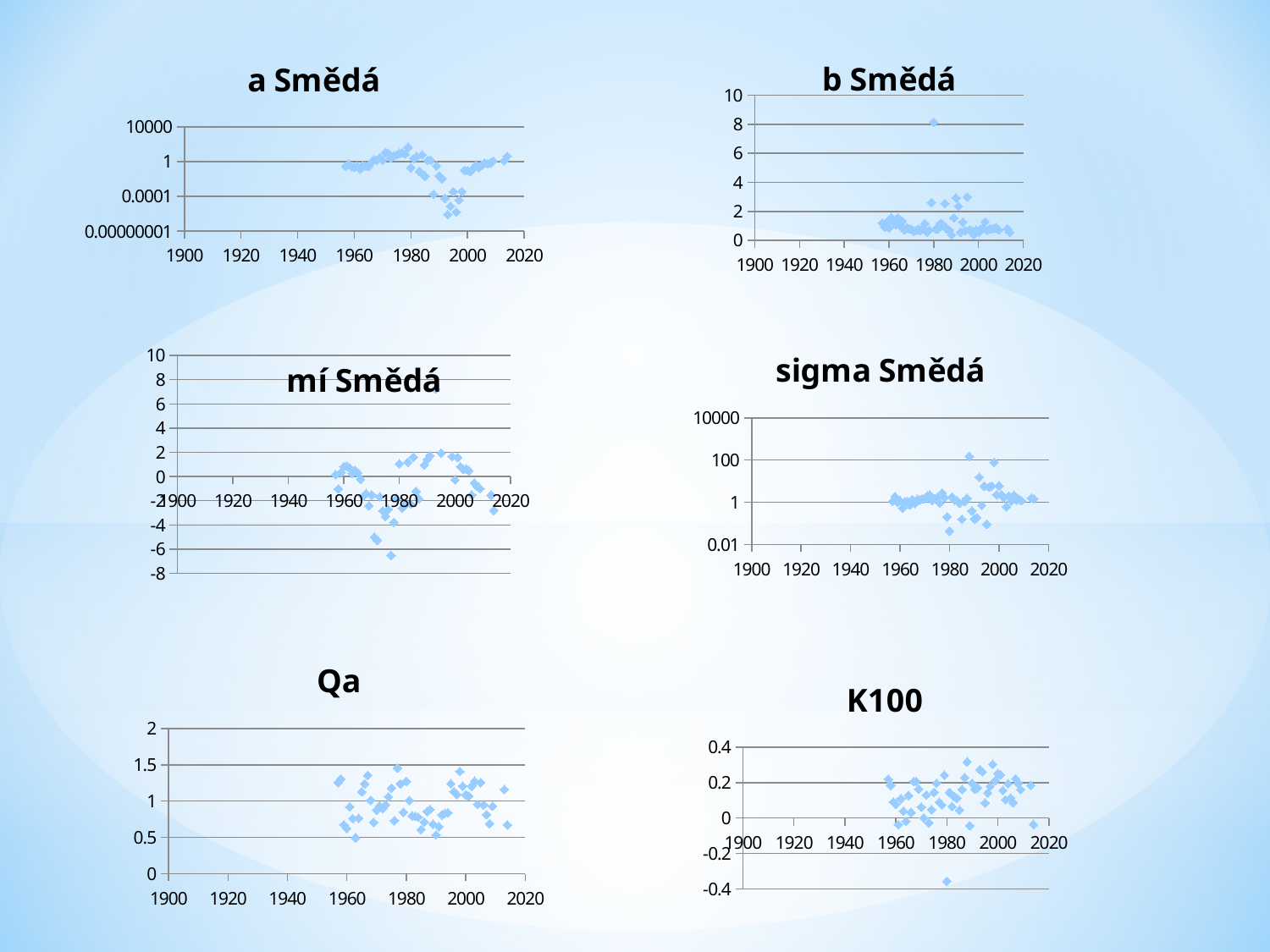
What is the title of the chart in the bottom-right position of the slide? K100 What is the highest value shown on the y axis of the "sigma Smědá" chart? 10000 What kind of chart is the "sigma Smědá" chart? scatter chart How many charts are shown on the slide? 6 In the "Qa" chart, is the highest plotted value greater or less than 1? greater In the "a Smědá" chart, is the lowest plotted value greater or less than 0.0001? less In the "K100" chart, is the lowest plotted value greater or less than -0.2? less What kind of chart is the "Qa" chart? scatter chart